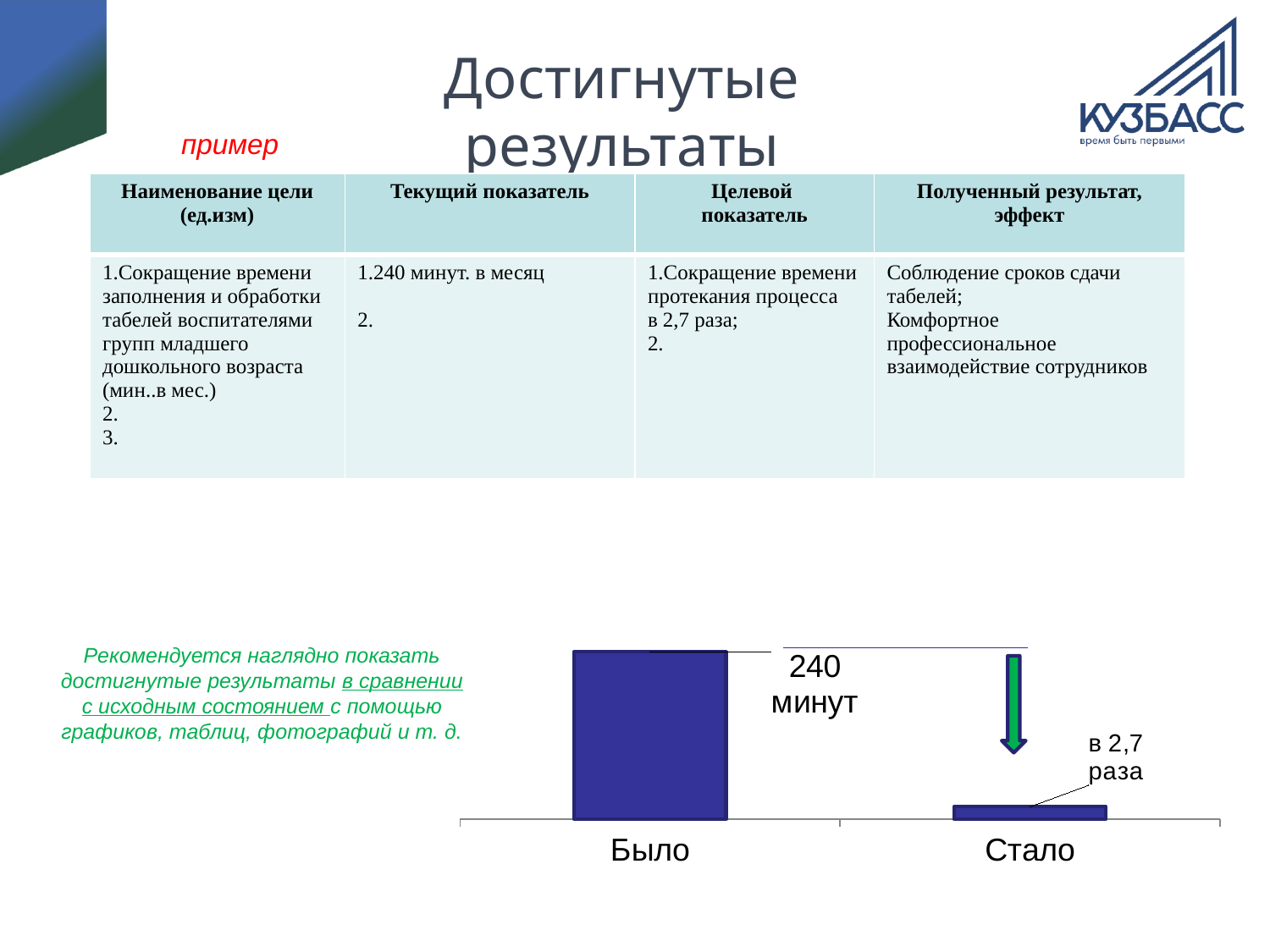
How many categories are shown on the x axis of the chart? 2 What kind of chart is shown on the slide? Bar chart Which category in the chart has the highest bar? Было What value is labelled on the "Было" bar in the chart? 240 минут What colour are the bars in the chart? Dark blue What annotation is written next to the "Стало" bar in the chart? в 2,7 раза Do the bar values rise or fall from "Было" to "Стало"? Fall Which category in the chart has the lowest bar? Стало Which bar is taller in the chart, "Было" or "Стало"? Было